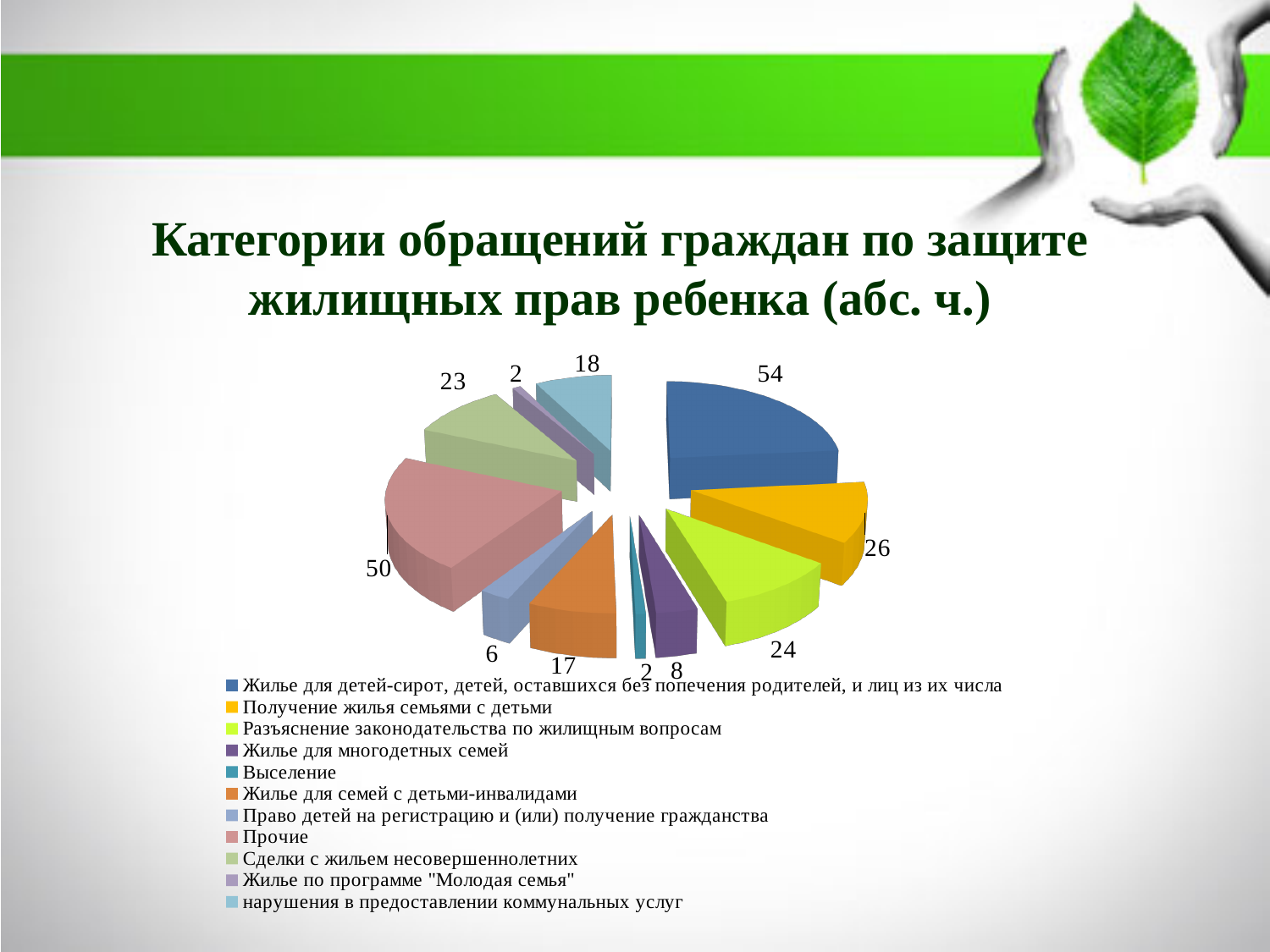
Which category has the highest value in the pie chart? Жилье для детей-сирот, детей, оставшихся без попечения родителей, и лиц из их числа What kind of chart is shown on the slide? pie chart What is the value for "Прочие"? 50 What is the value for "Разъяснение законодательства по жилищным вопросам"? 24 What is the difference between the values for "Получение жилья семьями с детьми" and "Жилье для многодетных семей"? 18 What is the value for "Сделки с жильем несовершеннолетних"? 23 What is the value for "Жилье для детей-сирот, детей, оставшихся без попечения родителей, и лиц из их числа"? 54 What is the difference between the values for "нарушения в предоставлении коммунальных услуг" and "Право детей на регистрацию и (или) получение гражданства"? 12 How many categories does the legend of the pie chart list? 11 What is the title of the chart on the slide? Категории обращений граждан по защите жилищных прав ребенка (абс. ч.) Which is larger: the value for "Прочие" or the value for "Получение жилья семьями с детьми"? Прочие What is the value for "Жилье для семей с детьми-инвалидами"? 17